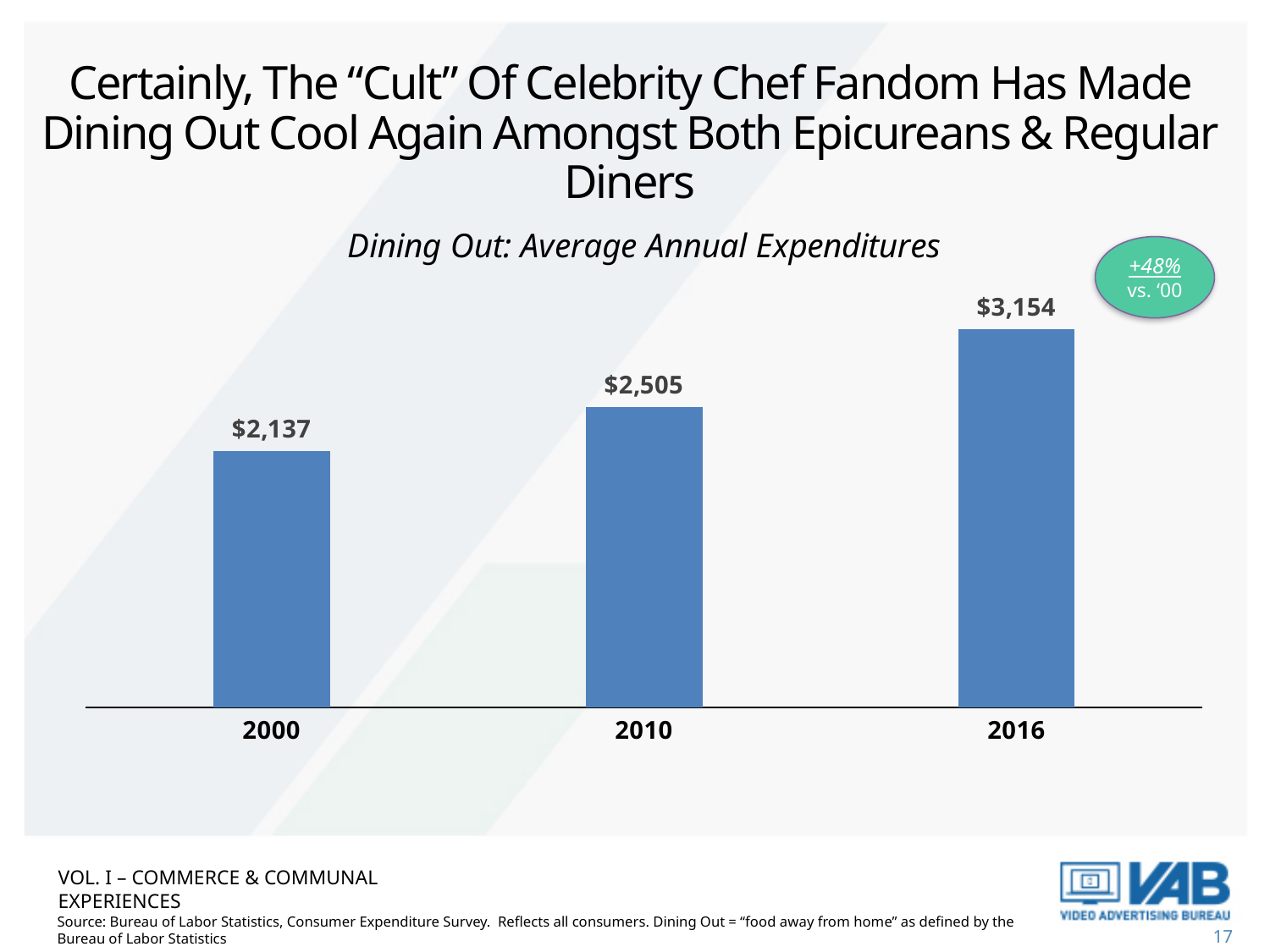
Which year has the lowest average annual dining out expenditure? 2000 What is the average annual dining out expenditure shown for 2010? $2,505 What is the title of the chart? Dining Out: Average Annual Expenditures Which year has the highest average annual dining out expenditure? 2016 What is the average annual dining out expenditure shown for 2000? $2,137 Which is larger, the expenditure for 2010 or for 2016? 2016 What is the difference between the 2016 and 2000 dining out expenditures? $1,017 What is the difference between the 2010 and 2000 dining out expenditures? $368 Do the dining out expenditures rise or fall from 2000 to 2016? Rise How many years are plotted in the chart? 3 What kind of chart is shown on the slide? Bar chart What is the average annual dining out expenditure shown for 2016? $3,154